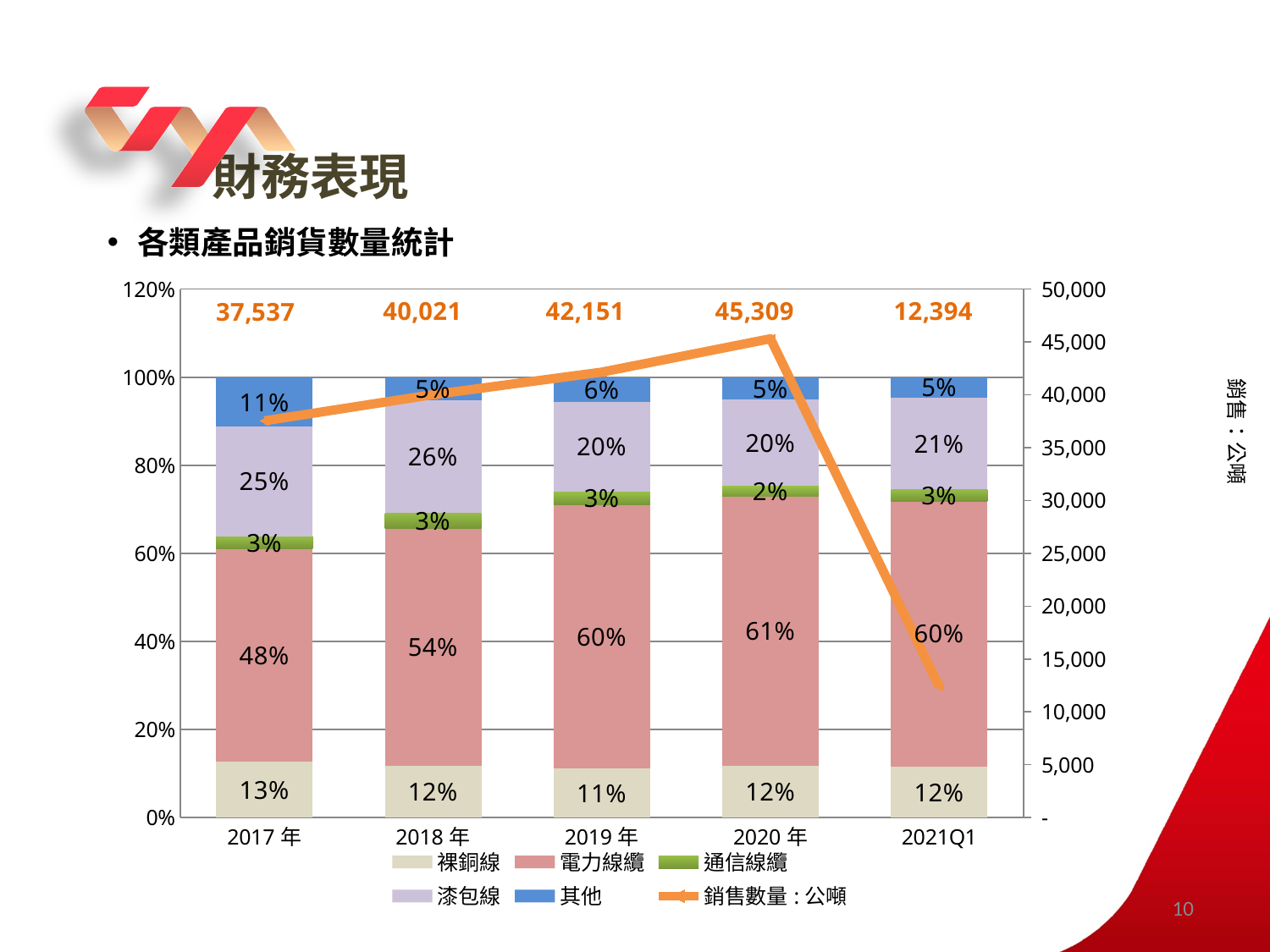
What percentage share does 漆包線 have in 2021Q1? 21% Does the 銷售數量 (公噸) line rise or fall from 2017 年 to 2020 年? Rise Which year has the highest 銷售數量 (公噸)? 2020 年 How many series does the legend list? 6 What percentage share does 電力線纜 have in 2019 年? 60% What is the value of 銷售數量 (公噸) for 2020 年? 45,309 Which period has the lowest 銷售數量 (公噸)? 2021Q1 How many periods are shown on the x axis? 5 Is the 電力線纜 share larger in 2018 年 or in 2020 年? 2020 年 What kind of chart is this? Stacked bar chart with a line What is the difference in 銷售數量 (公噸) between 2020 年 and 2019 年? 3,158 What percentage share does 其他 have in 2017 年? 11%